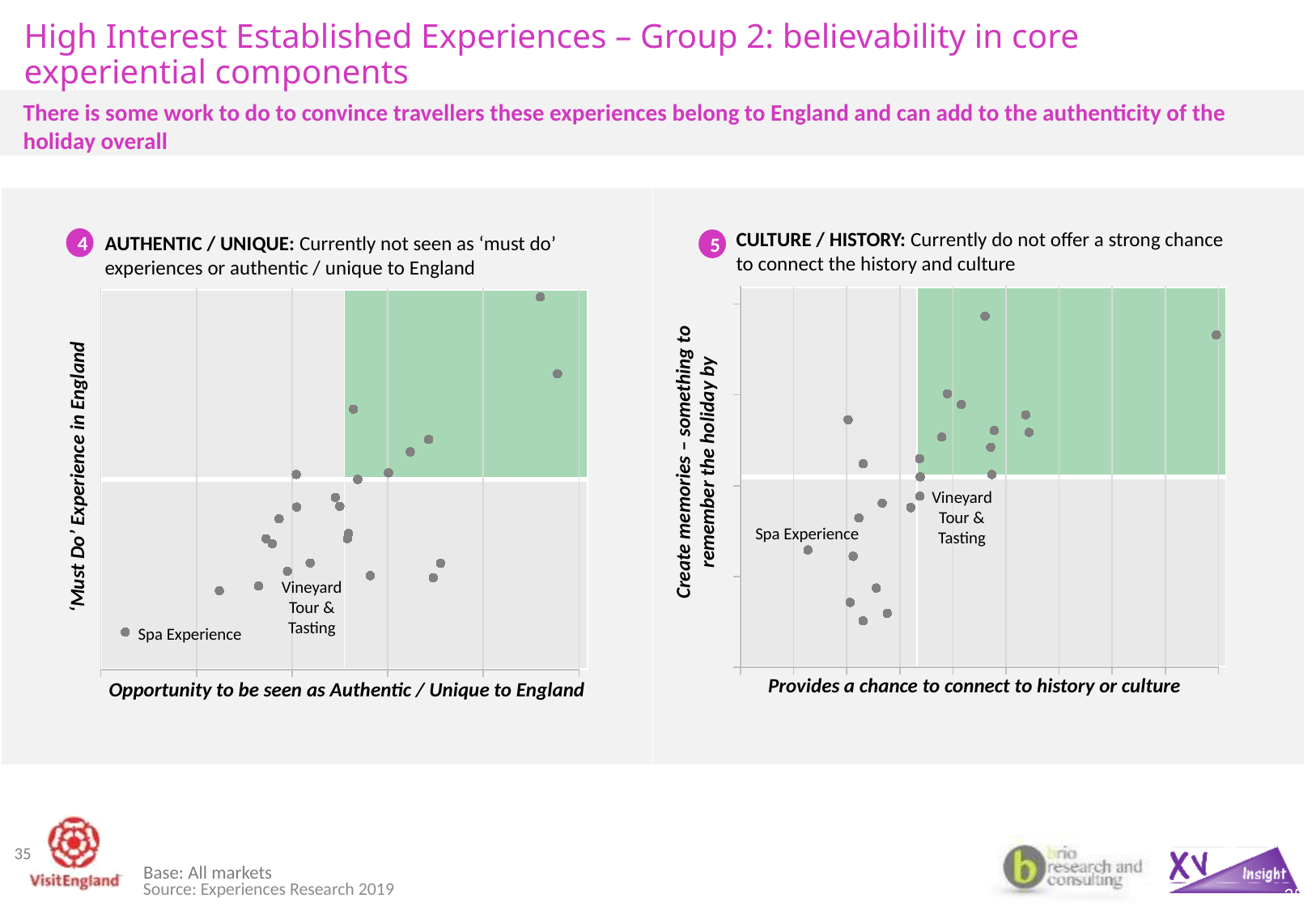
What is the x-axis title of the right chart (CULTURE / HISTORY)? Provides a chance to connect to history or culture On the right chart (CULTURE / HISTORY), which labelled experience is further right on the Provides a chance to connect to history or culture axis, Spa Experience or Vineyard Tour & Tasting? Vineyard Tour & Tasting On the right chart (CULTURE / HISTORY), which labelled experience is higher on the Create memories axis, Spa Experience or Vineyard Tour & Tasting? Vineyard Tour & Tasting On the left chart (AUTHENTIC / UNIQUE), which labelled experience is further right on the Opportunity to be seen as Authentic / Unique to England axis, Spa Experience or Vineyard Tour & Tasting? Vineyard Tour & Tasting How many data points are labelled by name on the right chart (CULTURE / HISTORY)? 2 What is the x-axis title of the left chart (AUTHENTIC / UNIQUE)? Opportunity to be seen as Authentic / Unique to England What kind of chart is the right chart (CULTURE / HISTORY)? Scatter chart What kind of chart is the left chart (AUTHENTIC / UNIQUE)? Scatter chart On the left chart (AUTHENTIC / UNIQUE), is the Spa Experience point inside the green shaded area? No